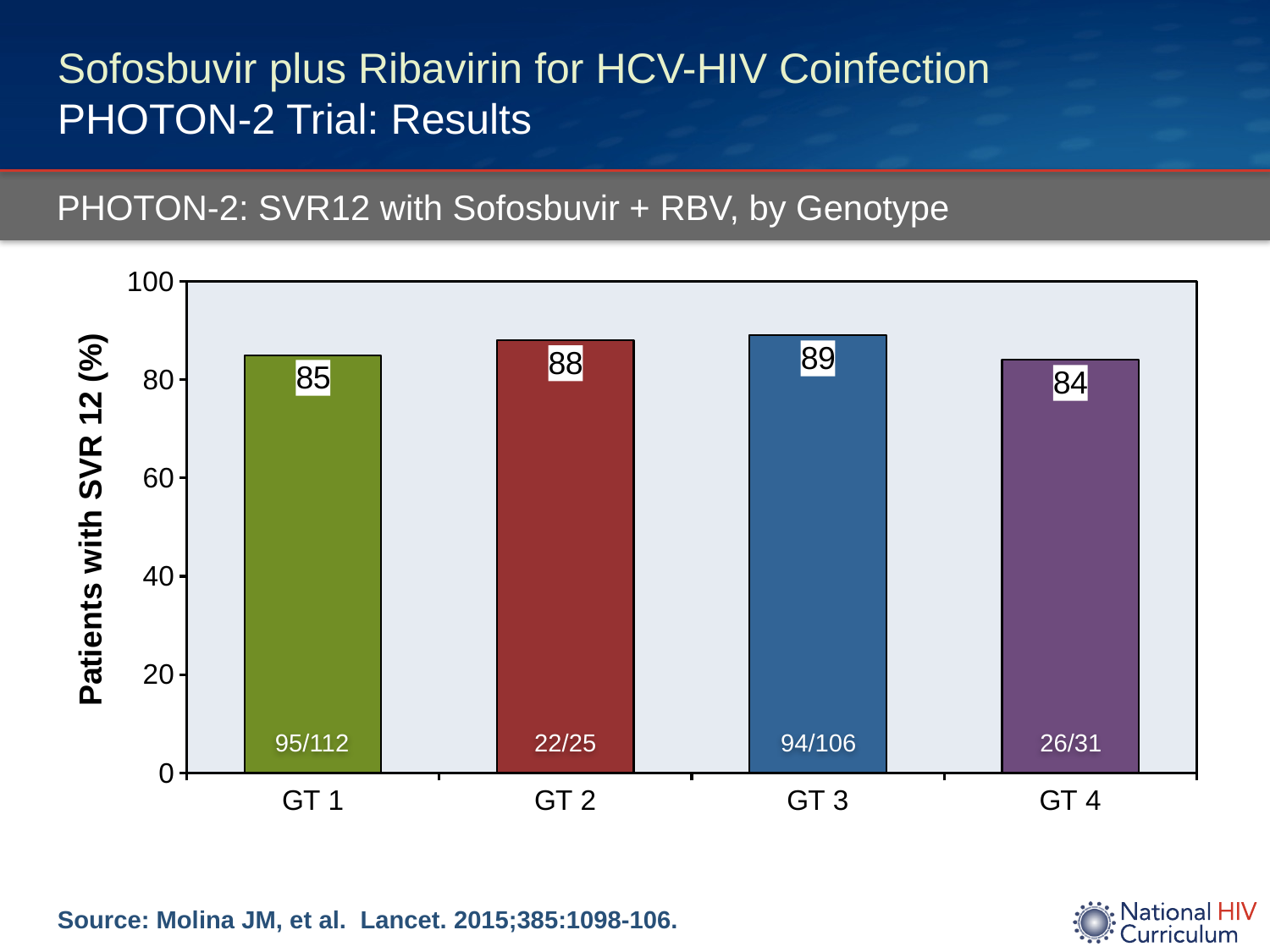
Which genotype has the highest SVR12 rate? GT 3 How many genotype categories are shown on the x axis? 4 What kind of chart is shown on the slide? Bar chart What is the SVR12 rate for GT 3? 89 What fraction of patients is printed at the bottom of the GT 2 bar? 22/25 Is the value for GT 1 greater or less than 80? greater What is the difference in SVR12 rate between GT 2 and GT 1? 3 Which genotype has the lowest SVR12 rate? GT 4 What is the SVR12 rate for GT 1? 85 What is the difference in SVR12 rate between GT 3 and GT 4? 5 What is the SVR12 rate for GT 4? 84 Which has a higher SVR12 rate, GT 2 or GT 4? GT 2